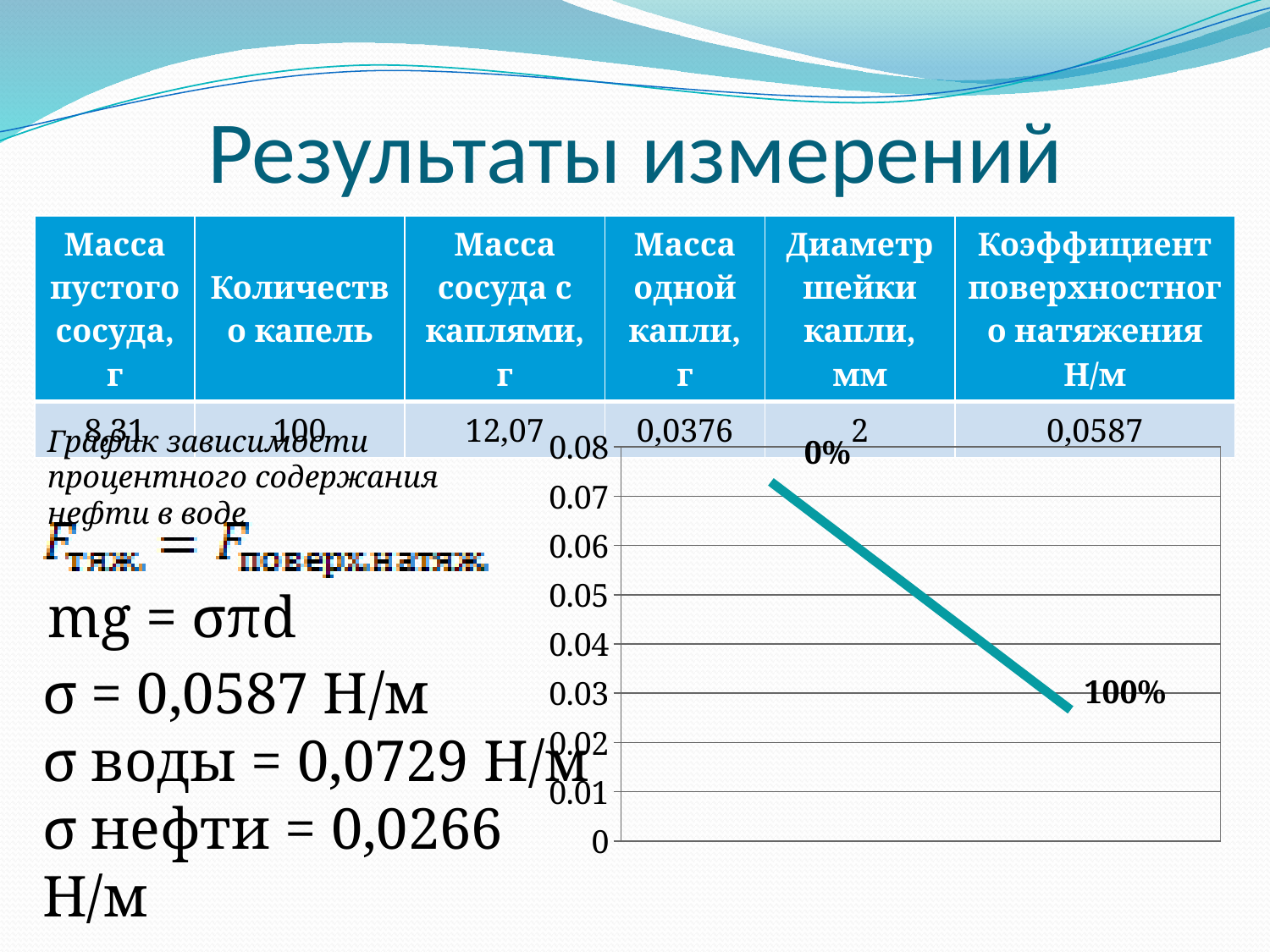
Which labelled point on the line chart has the lowest value? 100% Is the value at the 0% point greater or less than 0.06? greater What kind of chart is shown on the slide? line chart Which point on the line chart has the higher value, 0% or 100%? 0% How many data points are plotted on the line chart? 2 What is the highest tick value shown on the vertical axis of the line chart? 0.08 Is the value at the 0% point greater or less than 0.05? greater Does the line on the chart rise or fall from the 0% point to the 100% point? fall Is the value at the 100% point greater or less than 0.02? greater Which labelled point on the line chart has the highest value? 0% What are the two labels printed next to the points on the line chart? 0% and 100%